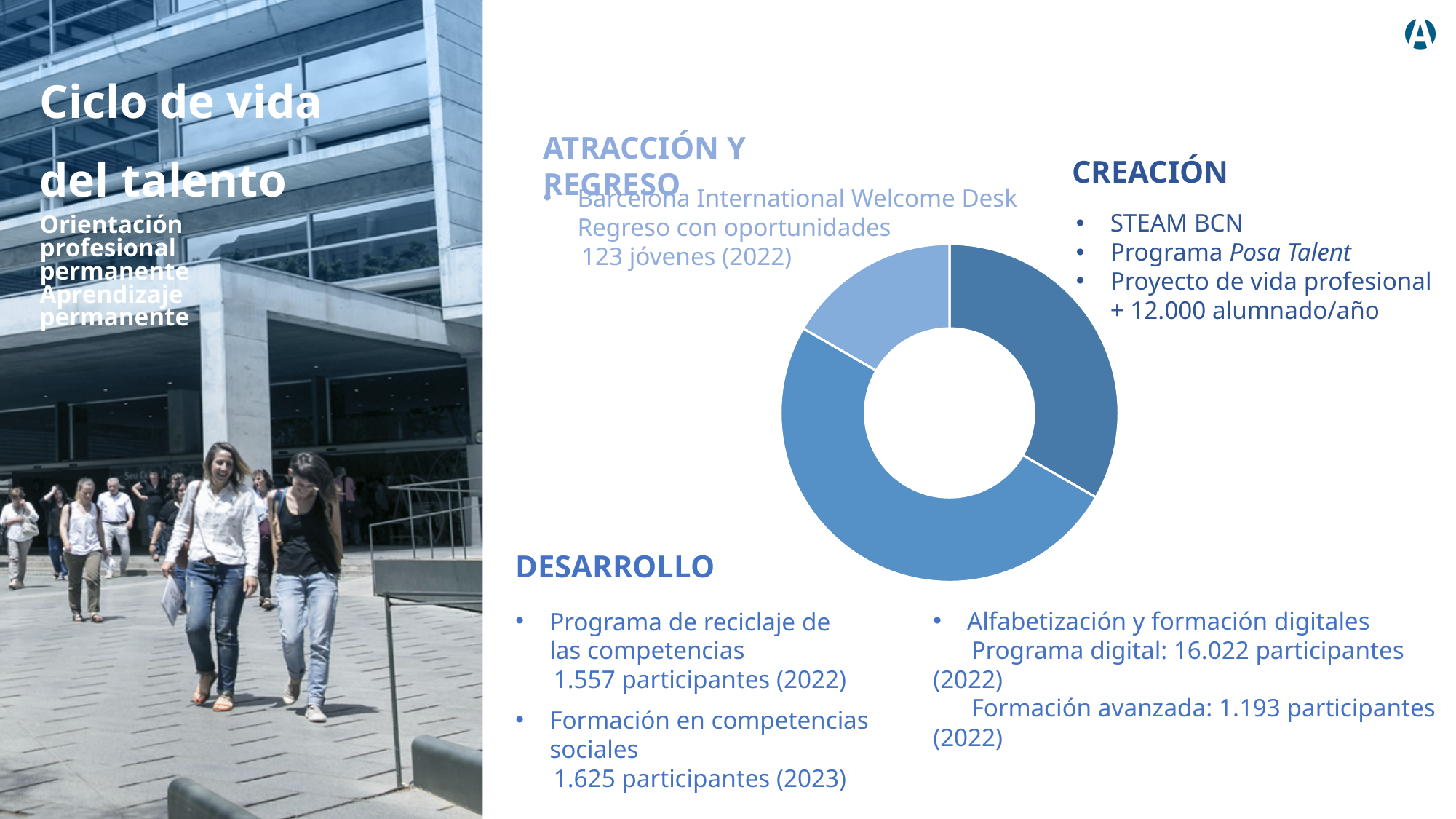
Which slice of the doughnut chart is the largest? The medium blue slice (bottom left) Which is larger in the doughnut chart: the dark blue slice on the right or the light blue slice at the top left? The dark blue slice on the right How many slices does the doughnut chart have? 3 Does the doughnut chart have a legend? No Does the doughnut chart display data labels with values? No Which slice of the doughnut chart is the smallest? The lightest blue slice (top left) What kind of chart is shown on the slide? Doughnut (pie) chart